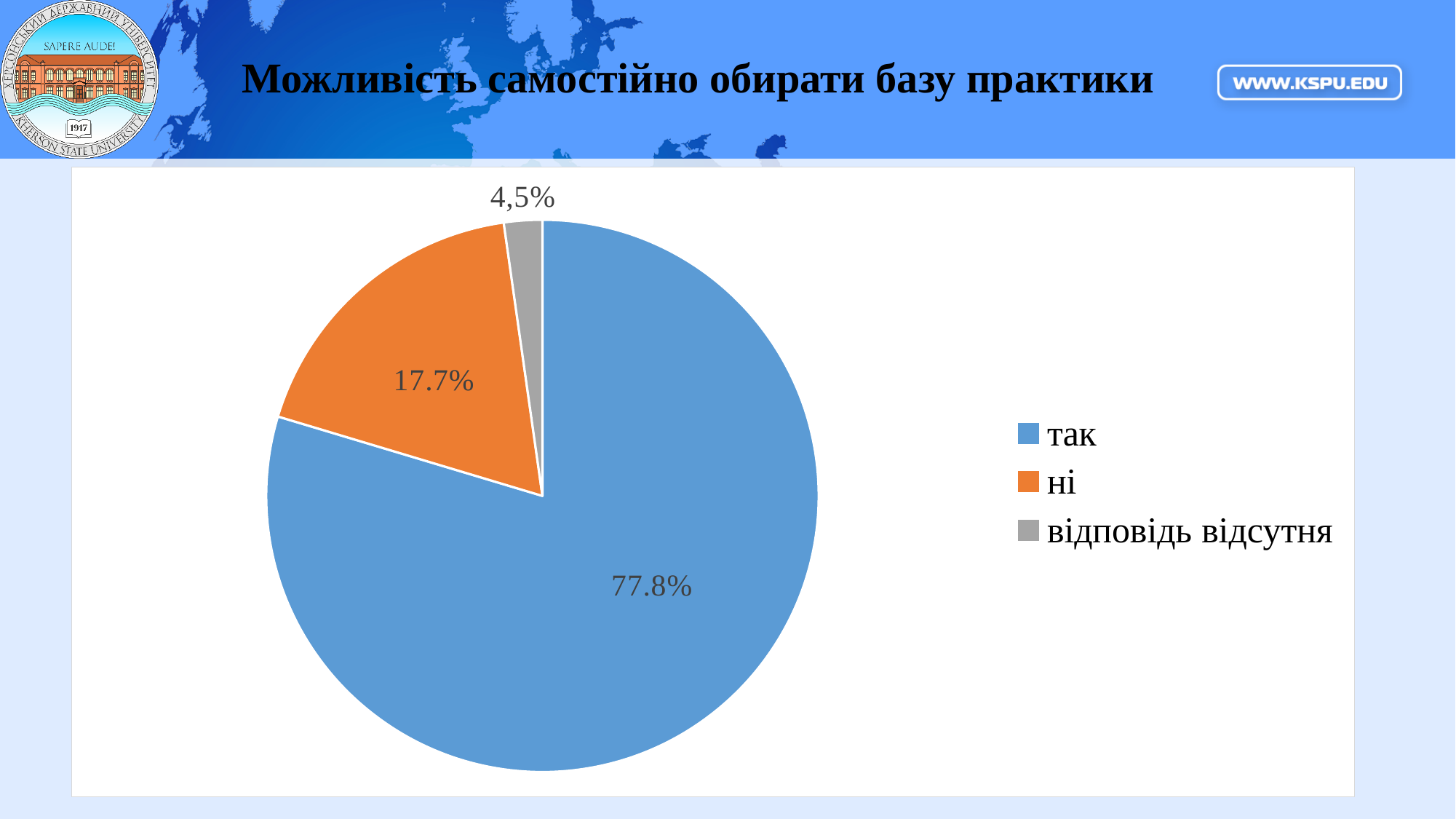
Which category has the smallest slice of the pie? відповідь відсутня How many entries does the legend list? 3 What kind of chart is shown on the slide? pie chart What is the value shown for the slice labelled "так"? 77.8% What colour is the slice for "ні"? orange What is the value shown for the slice labelled "відповідь відсутня"? 4,5% How many slices does the pie chart have? 3 What share of the pie does the "так" slice represent? 77.8% What is the value shown for the slice labelled "ні"? 17.7% What is the title of the slide above the chart? Можливість самостійно обирати базу практики Which category has the largest slice of the pie? так Which is larger, the slice for "ні" or the slice for "відповідь відсутня"? ні